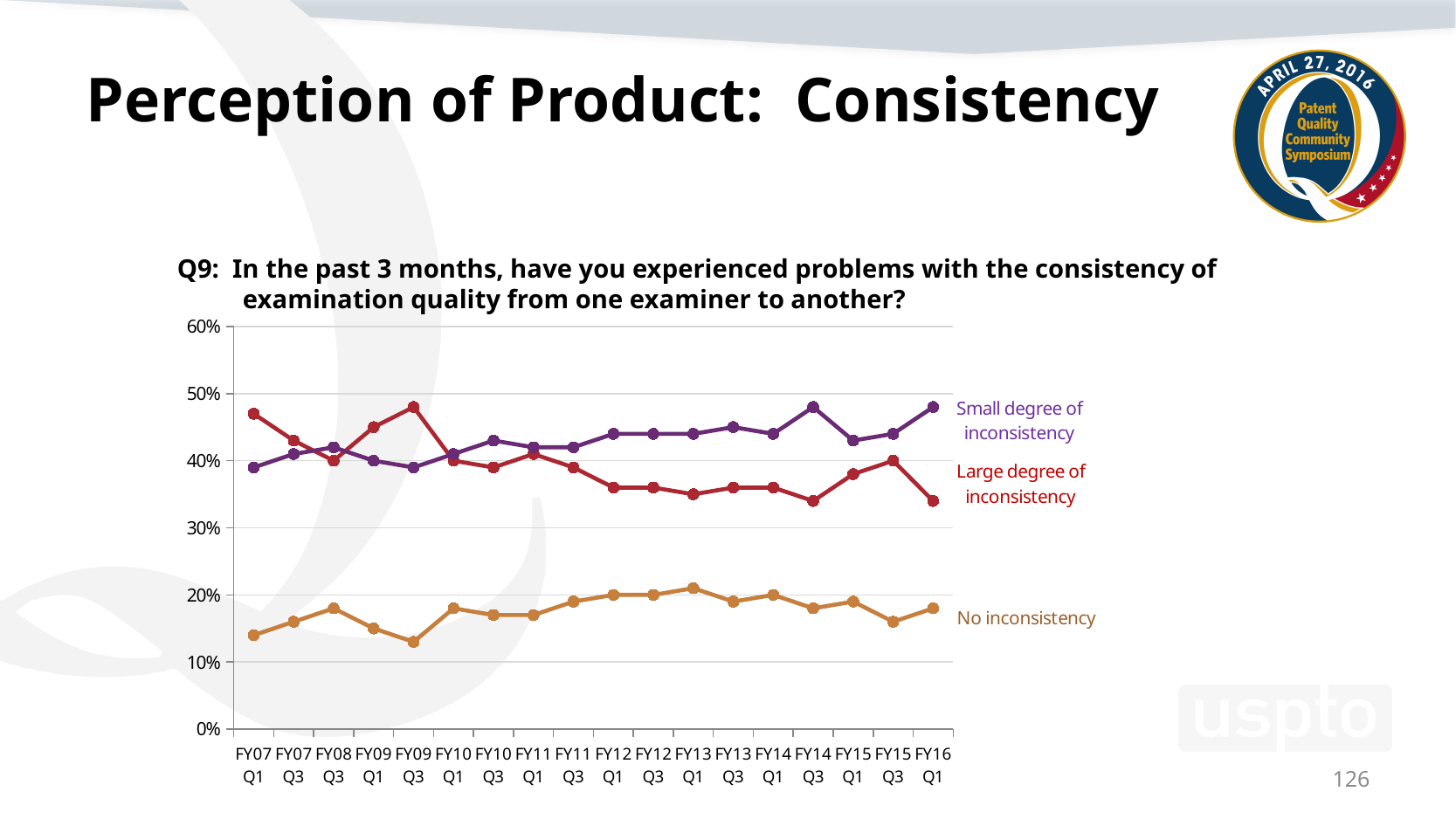
How many time points are shown along the x axis of the chart? 18 Does the Large degree of inconsistency series rise or fall overall from FY07 Q1 to FY16 Q1? Fall Is the value for Large degree of inconsistency at FY07 Q1 greater or less than 40%? greater Is the value for Large degree of inconsistency at FY16 Q1 greater or less than 40%? less At FY07 Q1, which is larger: Large degree of inconsistency or Small degree of inconsistency? Large degree of inconsistency Is the value for No inconsistency at FY09 Q3 greater or less than 20%? less What kind of chart is shown on the slide? Line chart At FY16 Q1, which is larger: Small degree of inconsistency or Large degree of inconsistency? Small degree of inconsistency Which series has the lowest values across the whole chart? No inconsistency What colour is the line for No inconsistency? Orange How many series are plotted on the chart? 3